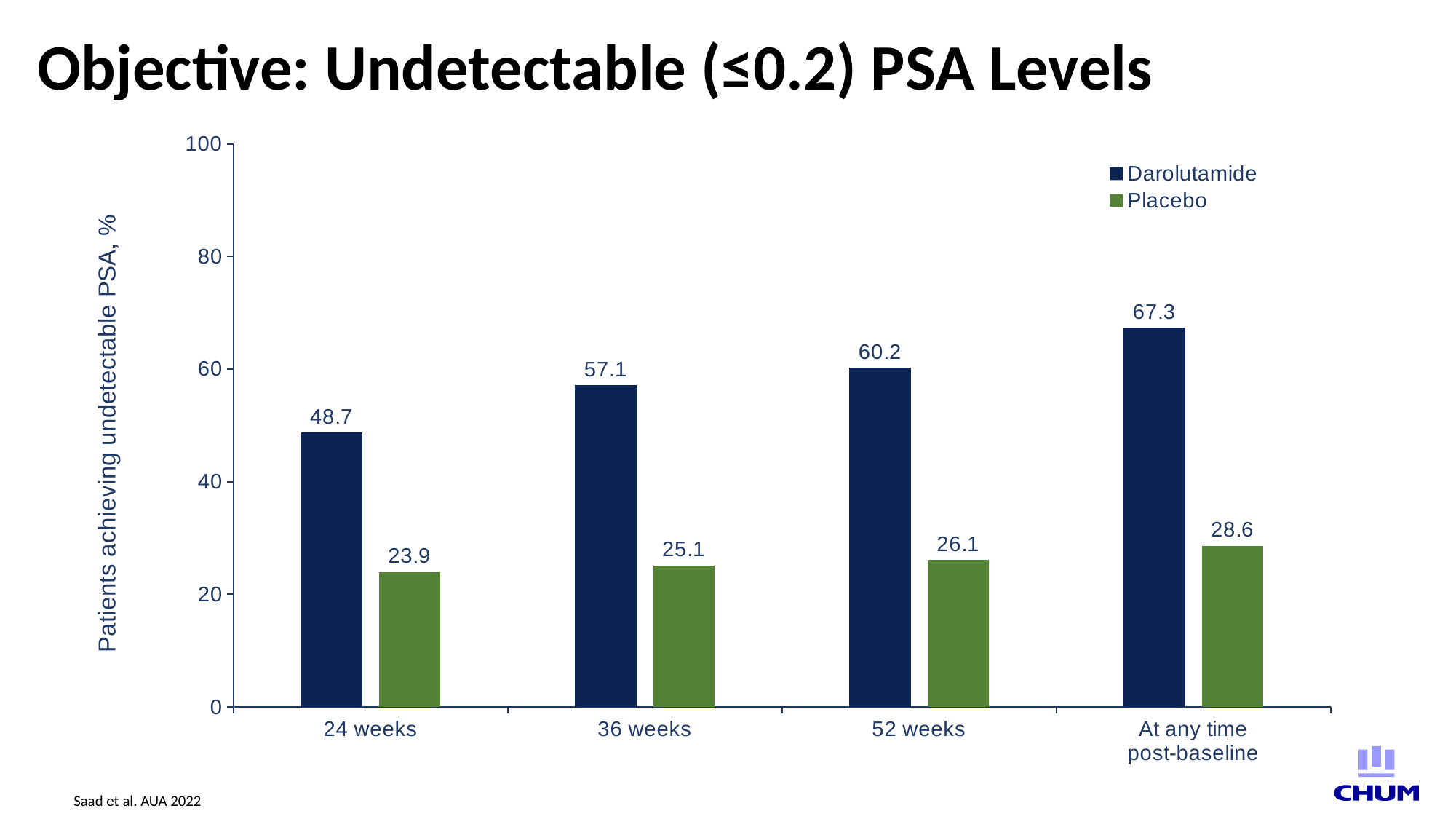
What is the value for Darolutamide at 24 weeks? 48.7 What is the value for Darolutamide at any time post-baseline? 67.3 Is the value for Darolutamide at 36 weeks greater or less than 60? less Which is larger at 52 weeks, Darolutamide or Placebo? Darolutamide What kind of chart is shown? Bar chart How many series does the legend list? 2 At which time point is the Darolutamide value highest? At any time post-baseline Do the Placebo values rise or fall from 24 weeks to any time post-baseline? Rise What is the difference between Darolutamide and Placebo at 36 weeks? 32 How many time-point categories are shown on the x axis? 4 At which time point is the Placebo value lowest? 24 weeks What is the value for Placebo at 52 weeks? 26.1